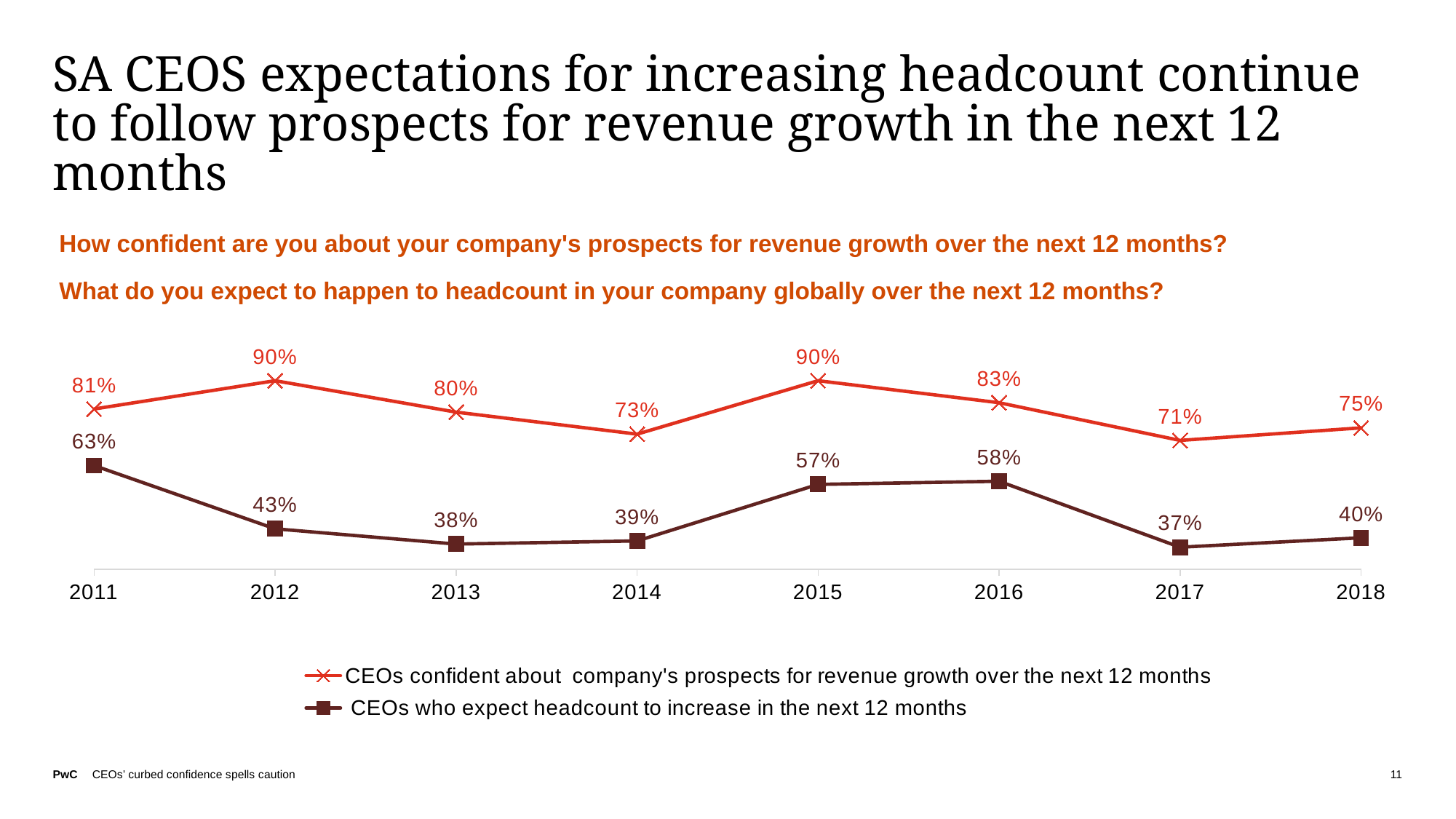
How many series does the legend list? 2 In which year was the share of CEOs expecting headcount to increase the lowest? 2017 What is the lowest value shown for CEOs confident about revenue growth prospects? 71% Did the share of CEOs confident about revenue growth rise or fall from 2016 to 2017? Fall What percentage of CEOs were confident about their company's prospects for revenue growth in 2015? 90% In which year was the share of CEOs expecting headcount to increase the highest? 2011 How many years are plotted on the x axis? 8 What kind of chart is shown on the slide? Line chart By how much did the share of CEOs expecting headcount to increase change from 2011 to 2012? 20% Which is larger: the headcount increase value in 2015 or in 2016? 2016 What percentage of CEOs expected headcount to increase in 2013? 38% What is the difference between the revenue growth confidence value and the headcount increase value in 2018? 35%